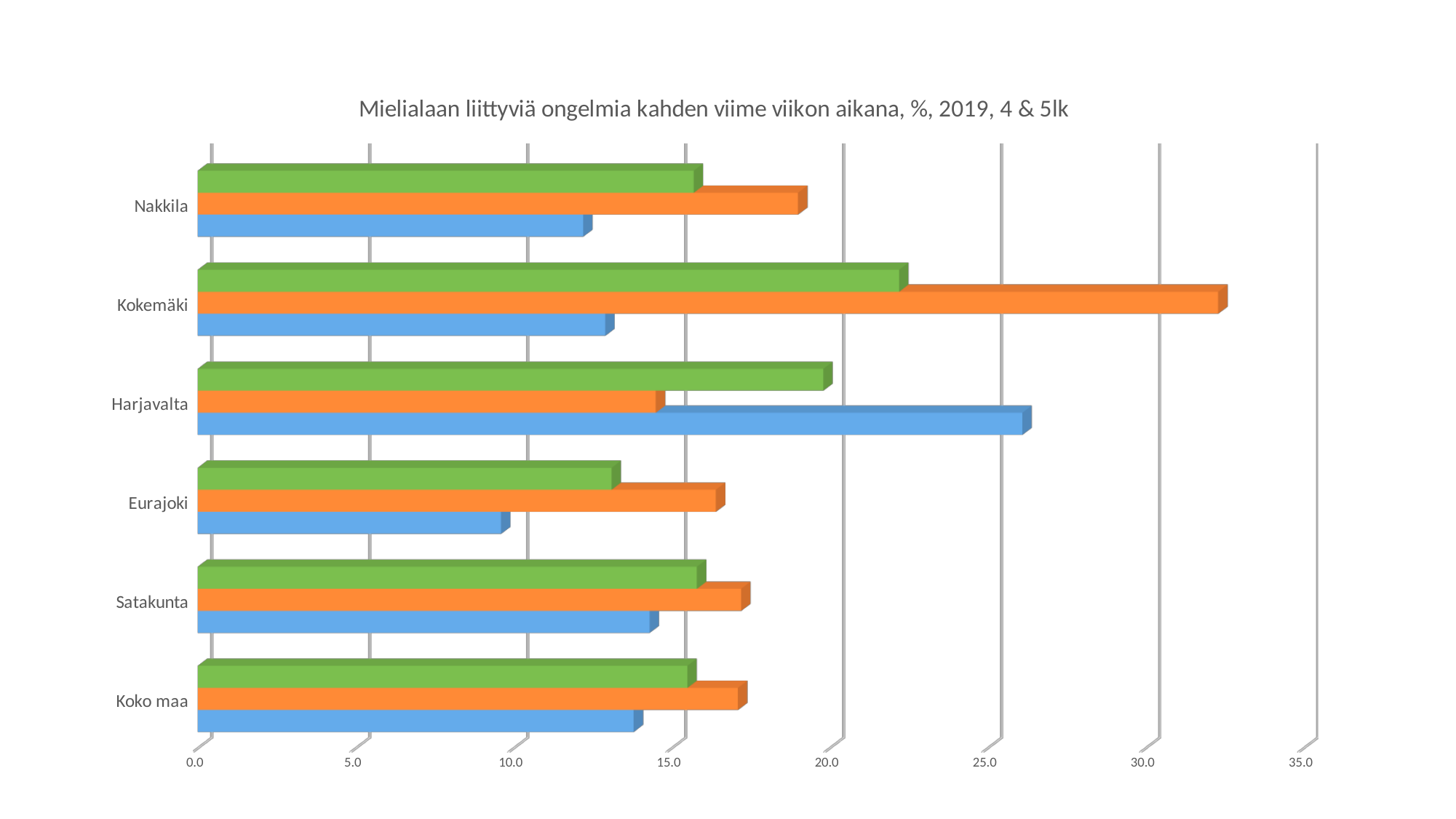
What is the title of the chart? Mielialaan liittyviä ongelmia kahden viime viikon aikana, %, 2019, 4 & 5lk Which category has the longest orange bar? Kokemäki Is the orange bar for Kokemäki greater or less than 30? greater What kind of chart is shown on the slide? bar chart How many bars are plotted for each category in the chart? 3 Is the blue bar for Harjavalta greater or less than 25? greater Is the green bar for Kokemäki greater or less than 20? greater Which category has the longest blue bar? Harjavalta Which category has the shortest blue bar? Eurajoki For Harjavalta, which is larger: the blue bar or the orange bar? the blue bar How many categories are shown on the vertical axis of the chart? 6